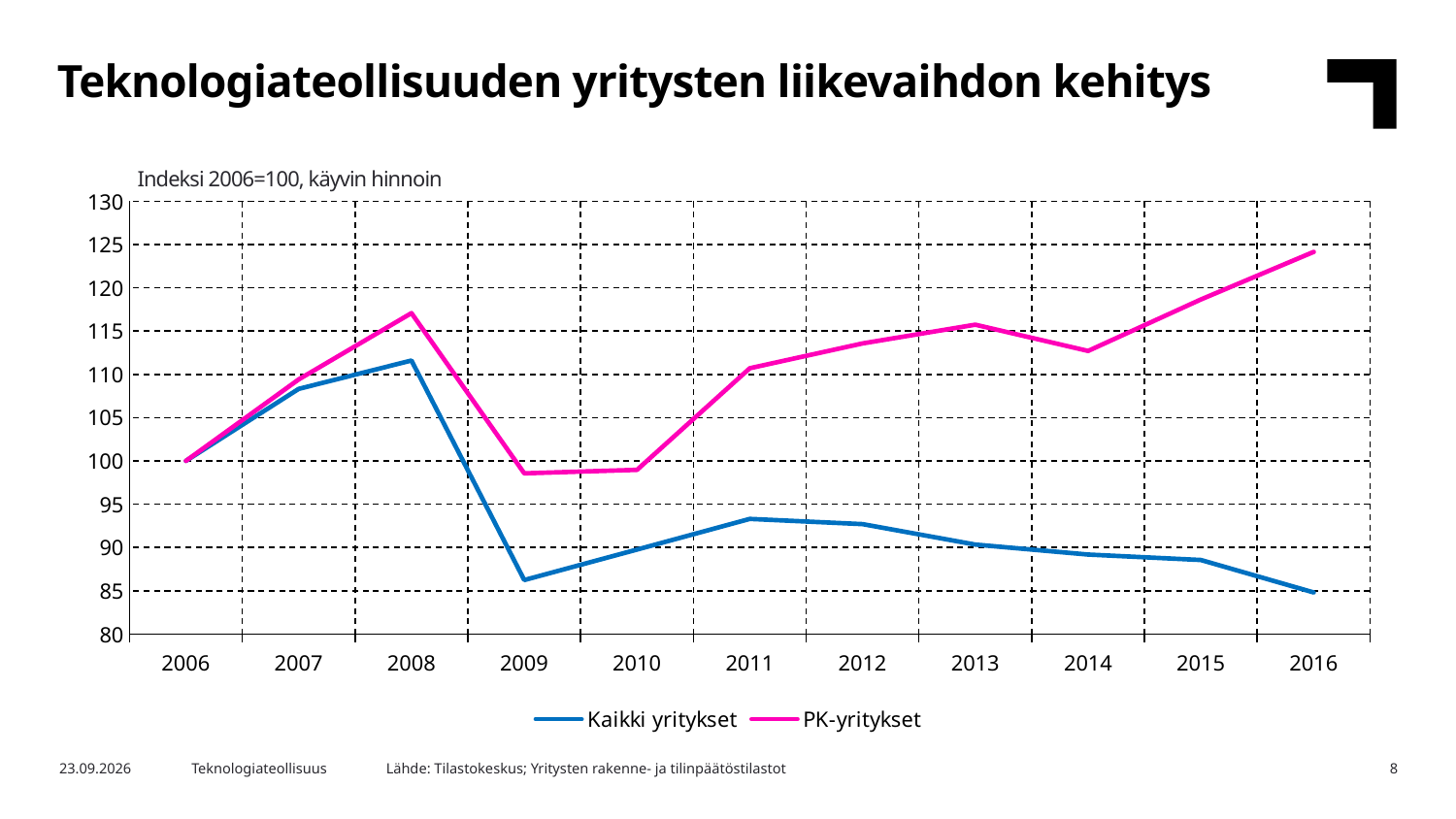
Which series is drawn in pink? PK-yritykset What kind of chart is shown on the slide? Line chart How many series does the legend list? 2 Is the value for Kaikki yritykset in 2009 greater or less than 90? less Is the value for PK-yritykset in 2016 greater or less than 120? greater In which year does the PK-yritykset series reach its highest value? 2016 In 2016, which series has the larger value, Kaikki yritykset or PK-yritykset? PK-yritykset What is the index value for both series in 2006? 100 Does the Kaikki yritykset series rise or fall from 2011 to 2016? Fall Is the value for PK-yritykset in 2008 greater or less than 115? greater In which year does the Kaikki yritykset series reach its highest value? 2008 How many years are plotted along the x axis? 11